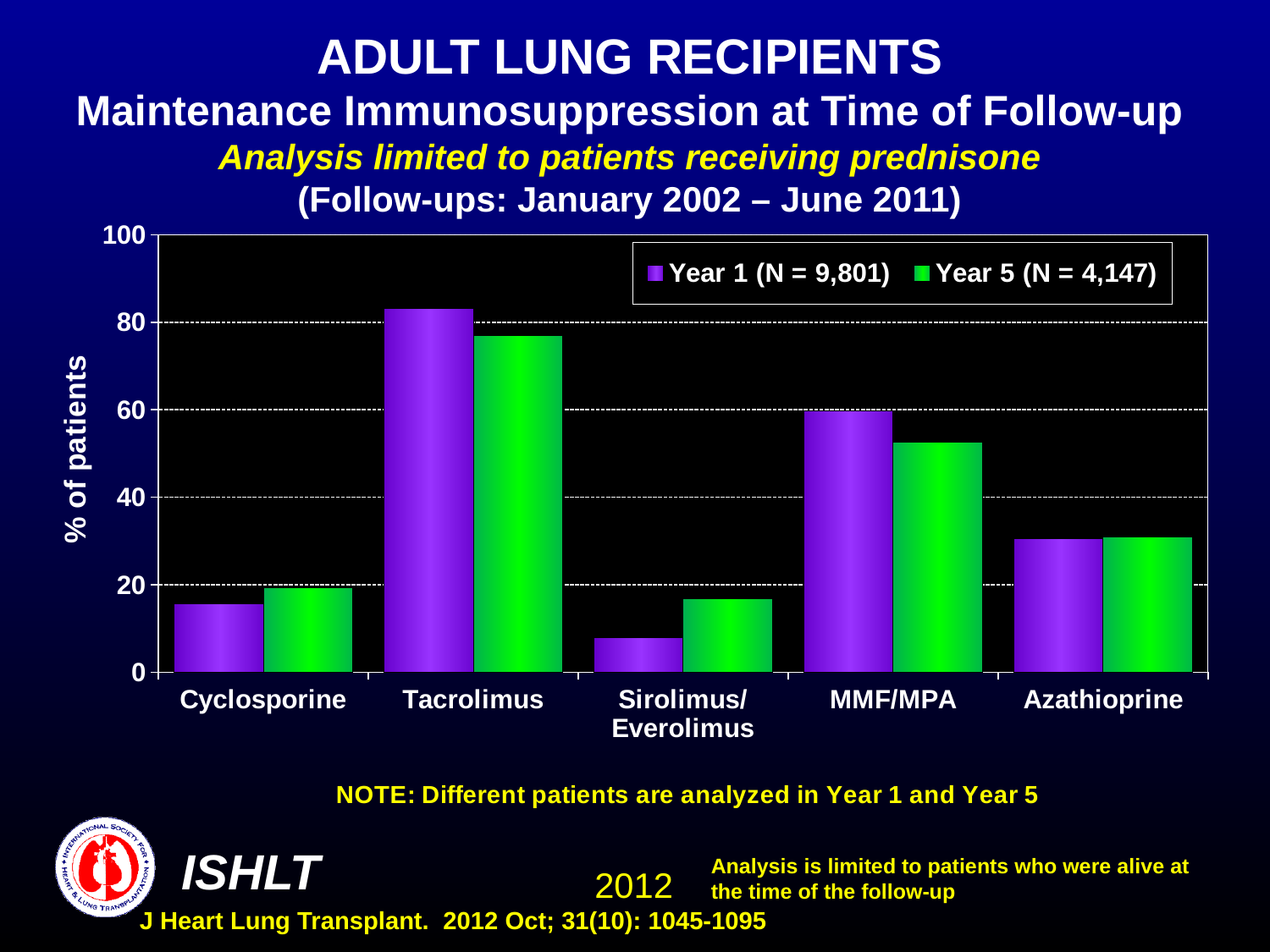
Is the Year 1 value for Azathioprine greater or less than 20? greater How many series does the legend list? 2 For Tacrolimus, which is larger: the Year 1 value or the Year 5 value? Year 1 Which drug has the lowest Year 1 value? Sirolimus/Everolimus What kind of chart is shown on the slide? bar chart Is the Year 5 value for MMF/MPA greater or less than 60? less Which drug has the highest Year 1 value? Tacrolimus For Cyclosporine, which is larger: the Year 1 value or the Year 5 value? Year 5 Is the Year 1 value for Tacrolimus greater or less than 80? greater What is the N given in the legend for Year 1? 9,801 How many drug categories are shown on the x axis? 5